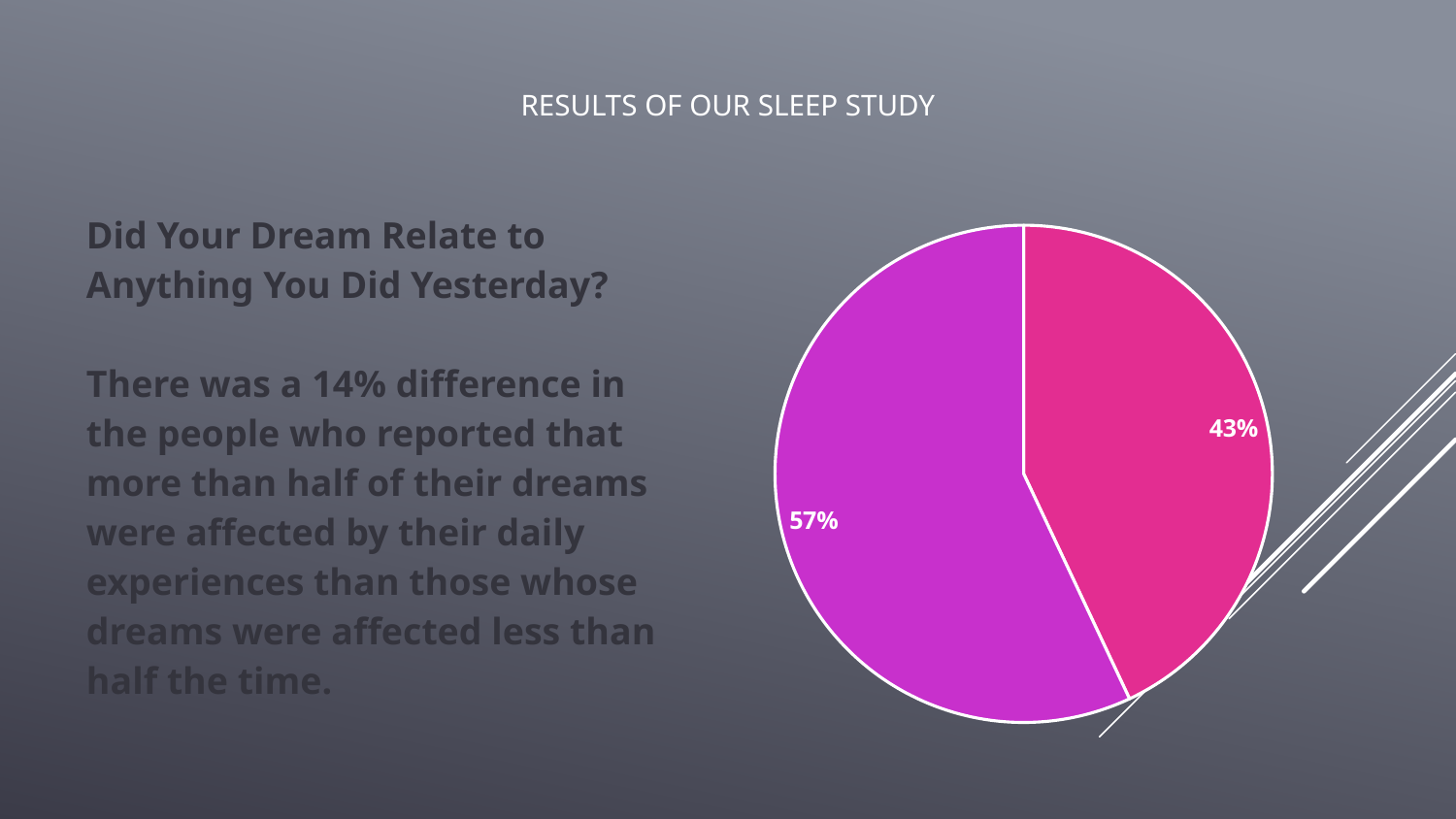
What is the title at the top of the slide? RESULTS OF OUR SLEEP STUDY Is the value of the pink slice greater or less than 50%? less What is the value of the smaller slice of the pie chart? 43% What is the difference between the two slices of the pie chart? 14% Which slice is larger, the purple one or the pink one? the purple one What value is labelled on the purple slice of the pie chart? 57% What kind of chart is shown on the slide? pie chart What do the two slices of the pie chart add up to? 100% What is the value of the larger slice of the pie chart? 57% What value is labelled on the pink slice of the pie chart? 43% How many slices does the pie chart have? 2 Is the value of the purple slice greater or less than 50%? greater